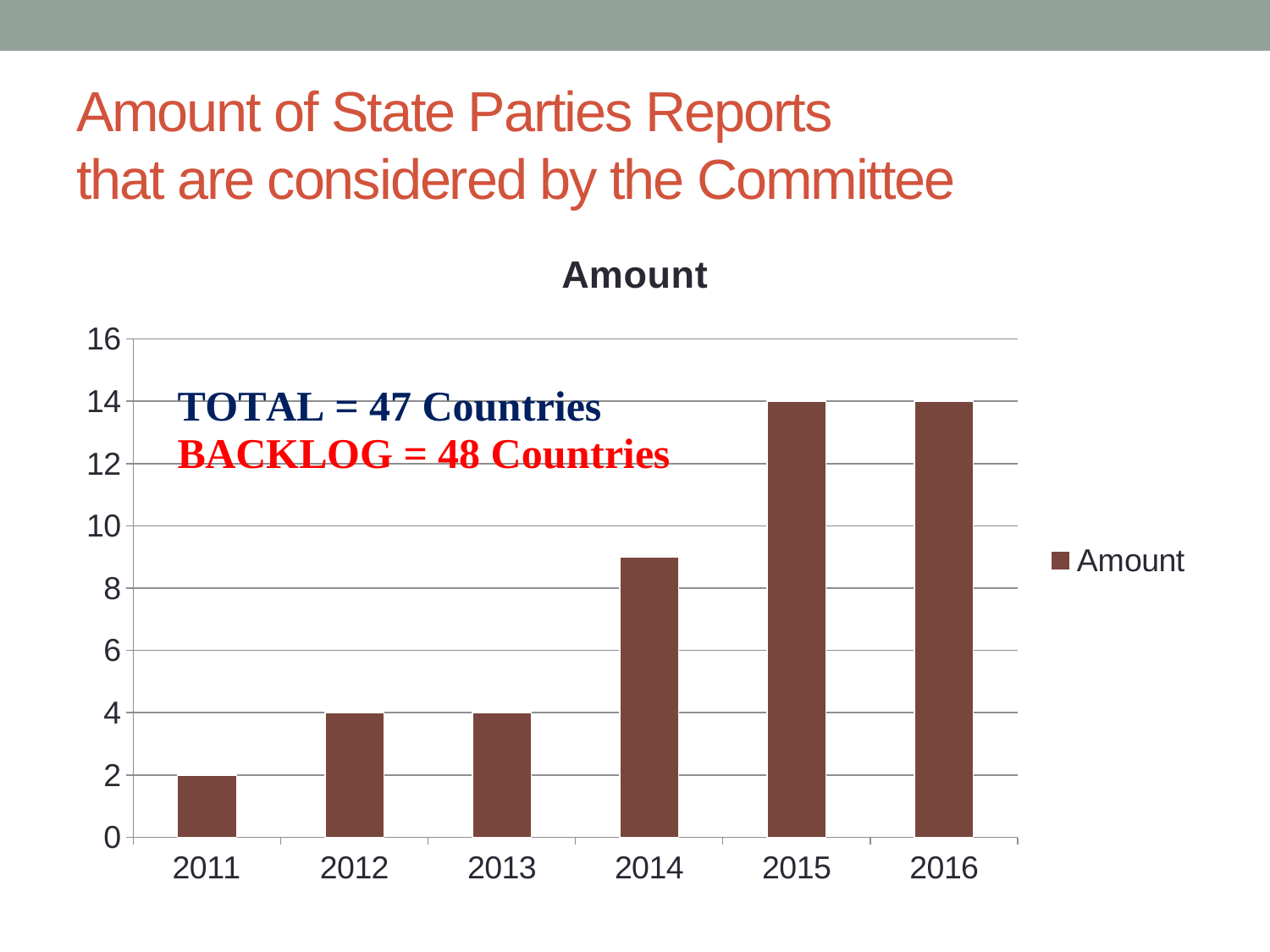
What is the difference between the values for 2015 and 2011? 12 What is the value for 2011? 2 How many series does the legend list? 1 What kind of chart is shown? bar chart Which year has the lowest value? 2011 Is the value for 2014 greater or less than 8? greater What is the value for 2016? 14 What is the value for 2012? 4 How many years are shown on the x axis? 6 What is the value for 2015? 14 Do the values generally rise or fall from 2011 to 2016? rise Which is larger, the value for 2014 or the value for 2013? 2014